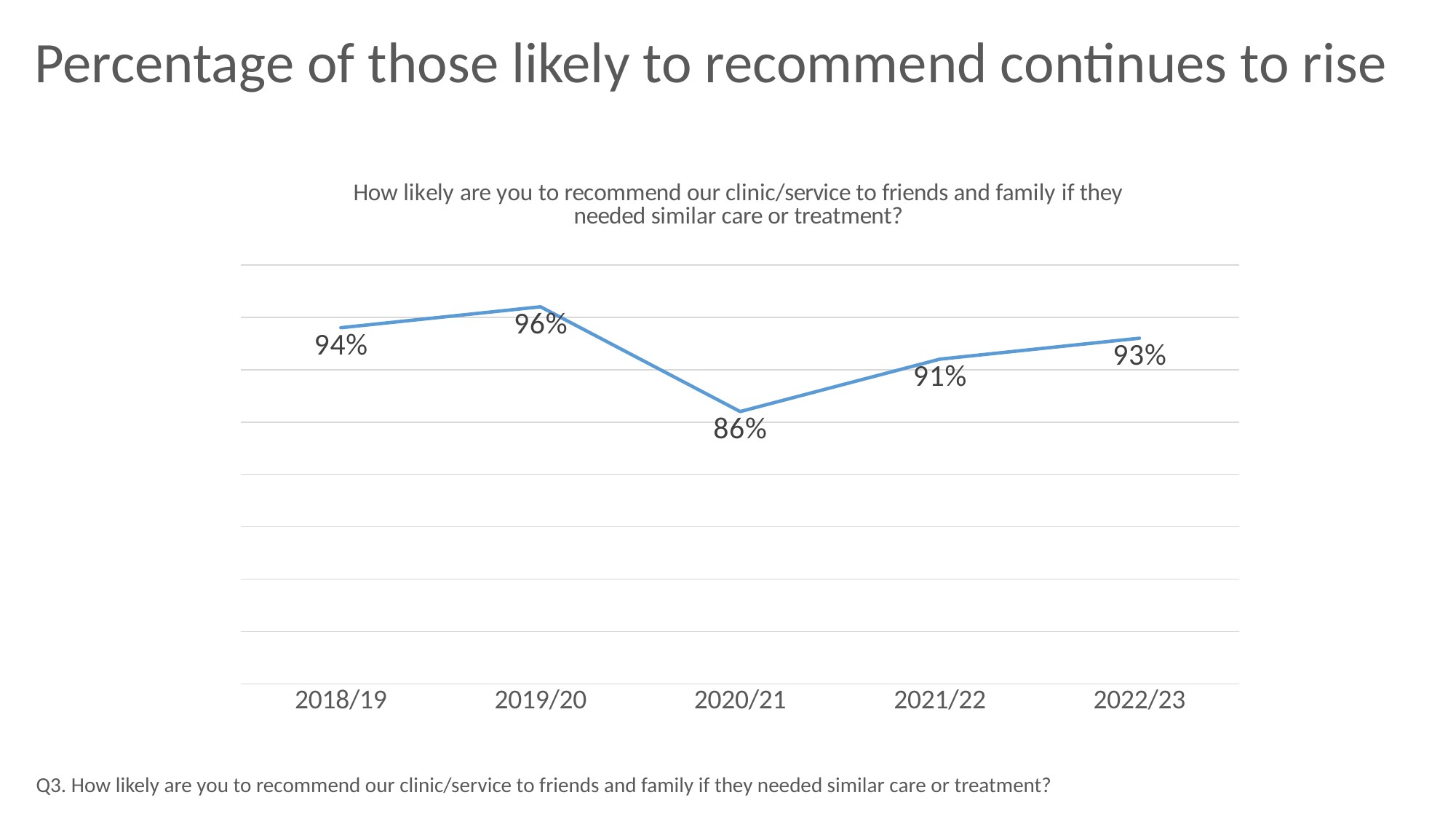
Do the values rise or fall from 2020/21 to 2022/23? rise Which year has the highest value? 2019/20 What is the title of the slide? Percentage of those likely to recommend continues to rise What kind of chart is shown on the slide? line chart What is the difference between the values for 2022/23 and 2021/22? 2% Which is larger, the value for 2018/19 or the value for 2022/23? 2018/19 What is the value for 2020/21? 86% What is the value for 2018/19? 94% What is the difference between the values for 2019/20 and 2020/21? 10% How many years are plotted on the chart? 5 What is the value for 2022/23? 93% Which year has the lowest value? 2020/21